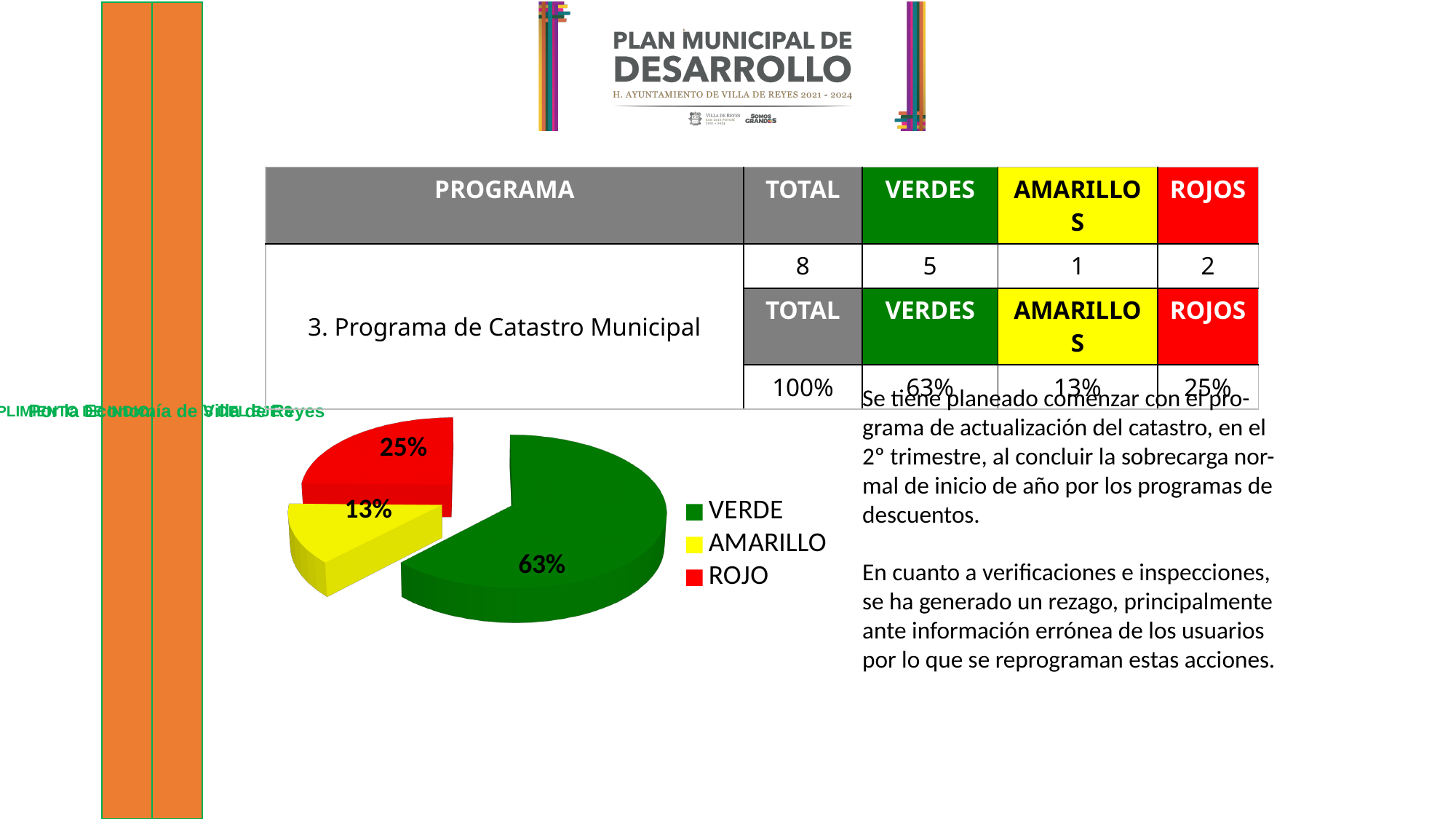
What share of the pie does ROJO represent? 25% What is the difference in percentage points between the VERDE and ROJO slices? 38 Which slice of the pie chart is the smallest? AMARILLO How many entries does the legend of the pie chart list? 3 What is the difference in percentage points between the ROJO and AMARILLO slices? 12 Which is larger in the pie chart, ROJO or AMARILLO? ROJO What share of the pie does AMARILLO represent? 13% What colour is the ROJO slice in the pie chart? Red Which slice of the pie chart is the largest? VERDE How many slices does the pie chart have? 3 What share of the pie does VERDE represent? 63% What kind of chart is shown on the slide? Pie chart